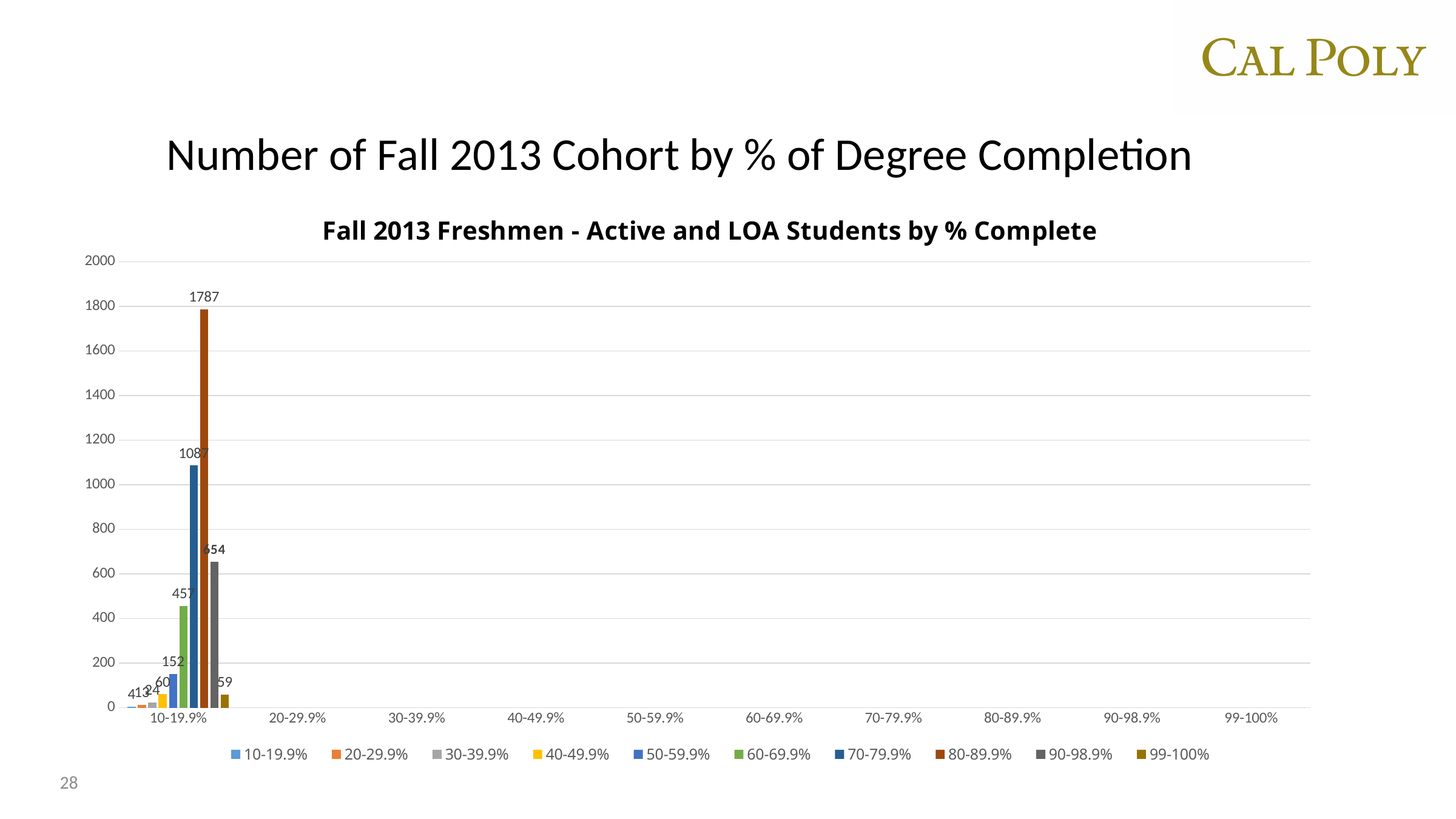
Which series has the highest value? 80-89.9% What kind of chart is shown on the slide? bar chart What is the value of the 50-59.9% series? 152 What is the value of the 70-79.9% series? 1087 What is the value of the 60-69.9% series? 457 What is the value of the 99-100% series? 59 What is the value of the 90-98.9% series? 654 What is the title of the chart? Fall 2013 Freshmen - Active and LOA Students by % Complete How many series does the legend list? 10 What is the difference between the 80-89.9% value and the 70-79.9% value? 700 What is the value of the 80-89.9% series? 1787 Which is larger, the 90-98.9% value or the 60-69.9% value? 90-98.9%